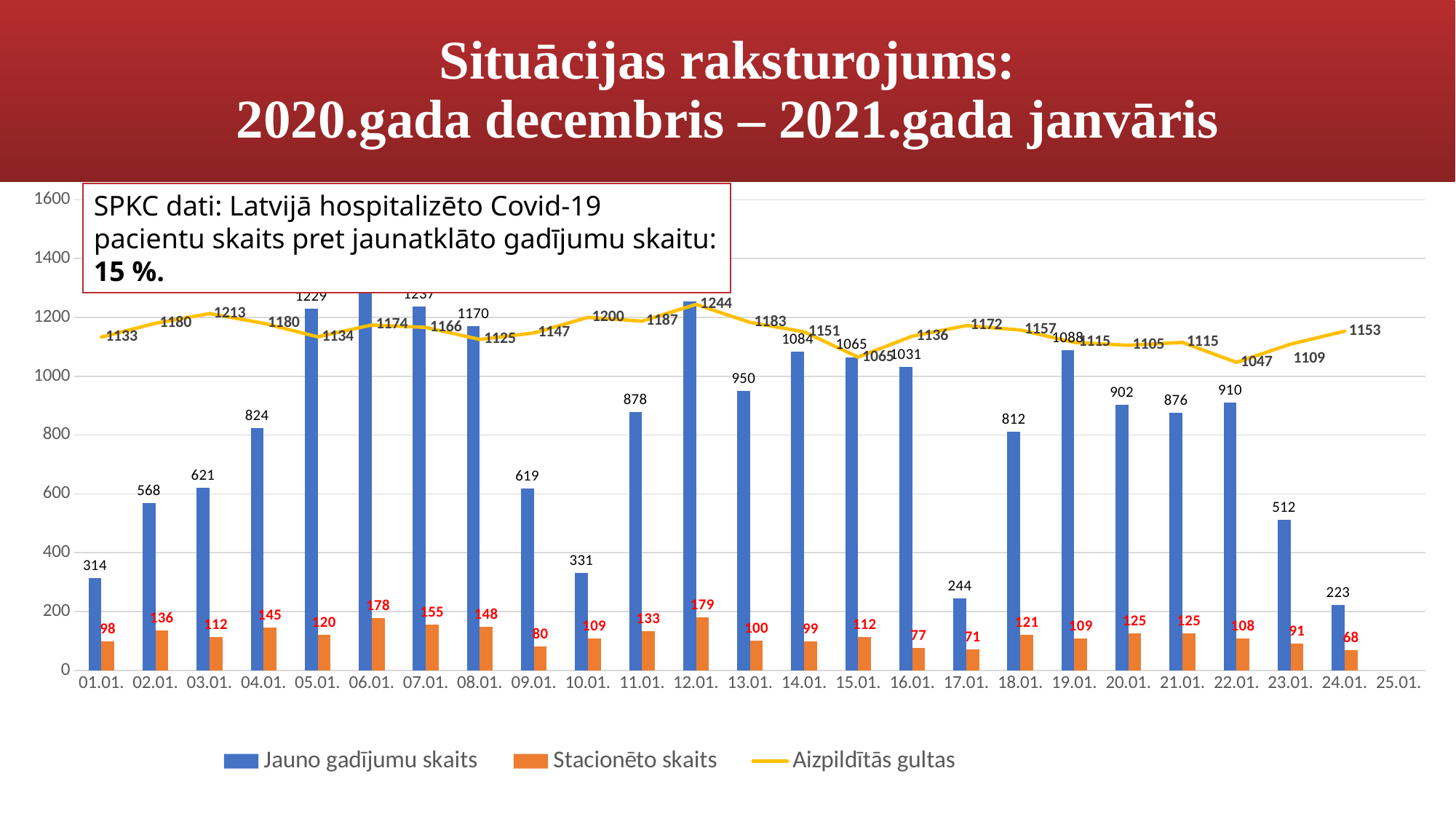
On which date is Jauno gadījumu skaits the lowest? 24.01. Is the value of Jauno gadījumu skaits on 06.01. greater or less than 1200? greater What is the value of Aizpildītās gultas on 03.01.? 1213 How many series does the legend list? 3 Does Jauno gadījumu skaits rise or fall from 01.01. to 05.01.? rise What is the value of Jauno gadījumu skaits on 04.01.? 824 What is the difference in Jauno gadījumu skaits between 02.01. and 01.01.? 254 What is the value of Stacionēto skaits on 17.01.? 71 What is the value of Stacionēto skaits on 06.01.? 178 Which date has a higher Jauno gadījumu skaits, 11.01. or 13.01.? 13.01. On which date is Aizpildītās gultas the highest? 12.01. On which date is Stacionēto skaits the lowest? 24.01.